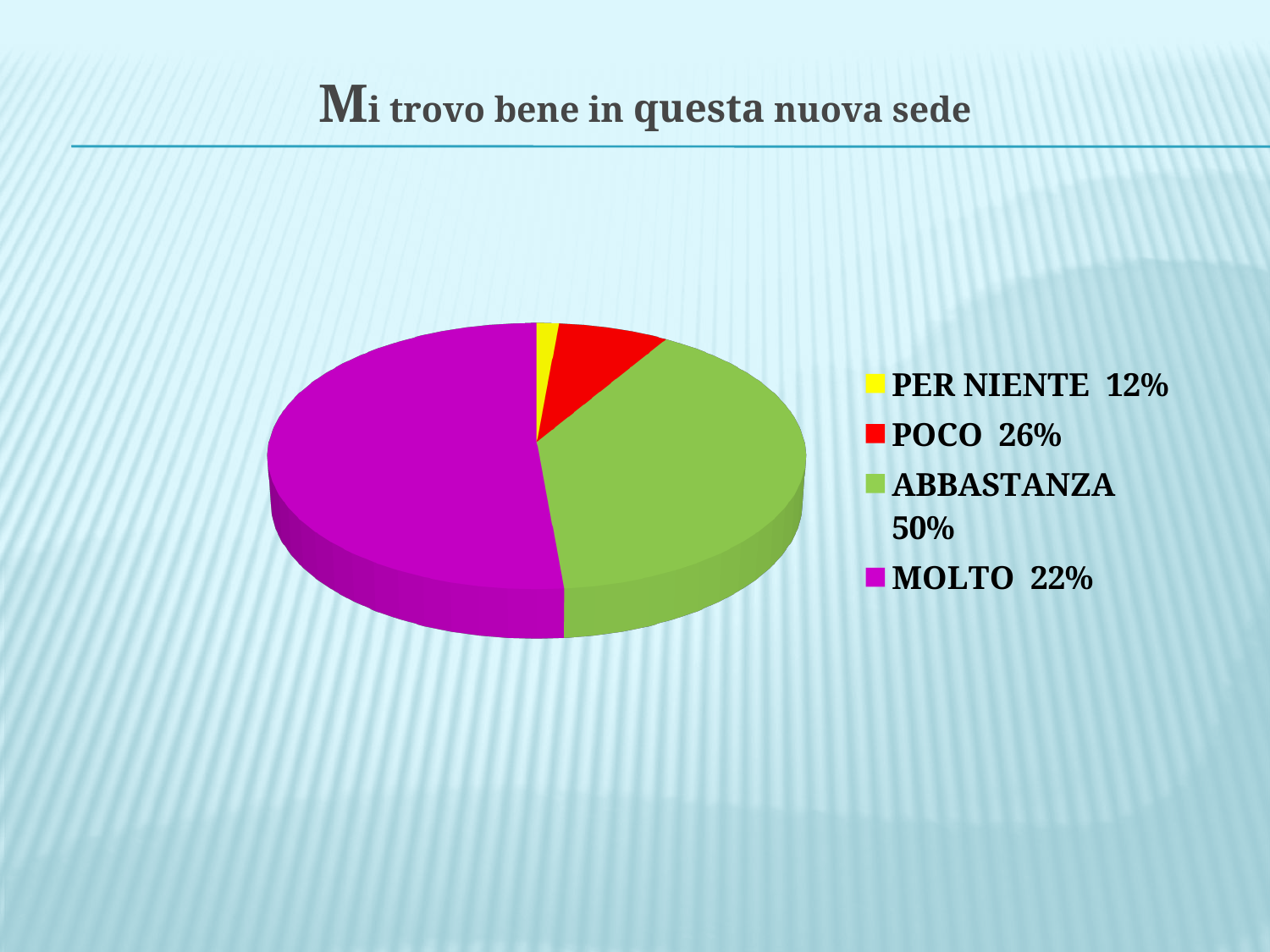
What percentage is shown for ABBASTANZA in the legend? 50% Which is larger, the share for POCO or the share for PER NIENTE? POCO What is the title of the chart on the slide? Mi trovo bene in questa nuova sede What is the difference between the percentages shown for ABBASTANZA and POCO? 24% How many categories does the pie chart have? 4 Which is larger, the share for ABBASTANZA or the share for POCO? ABBASTANZA Which category has the smallest slice of the pie? PER NIENTE What percentage is shown for PER NIENTE in the legend? 12% What percentage is shown for MOLTO in the legend? 22% What percentage is shown for POCO in the legend? 26% What colour is the MOLTO slice in the pie chart? purple What kind of chart is shown on the slide? pie chart